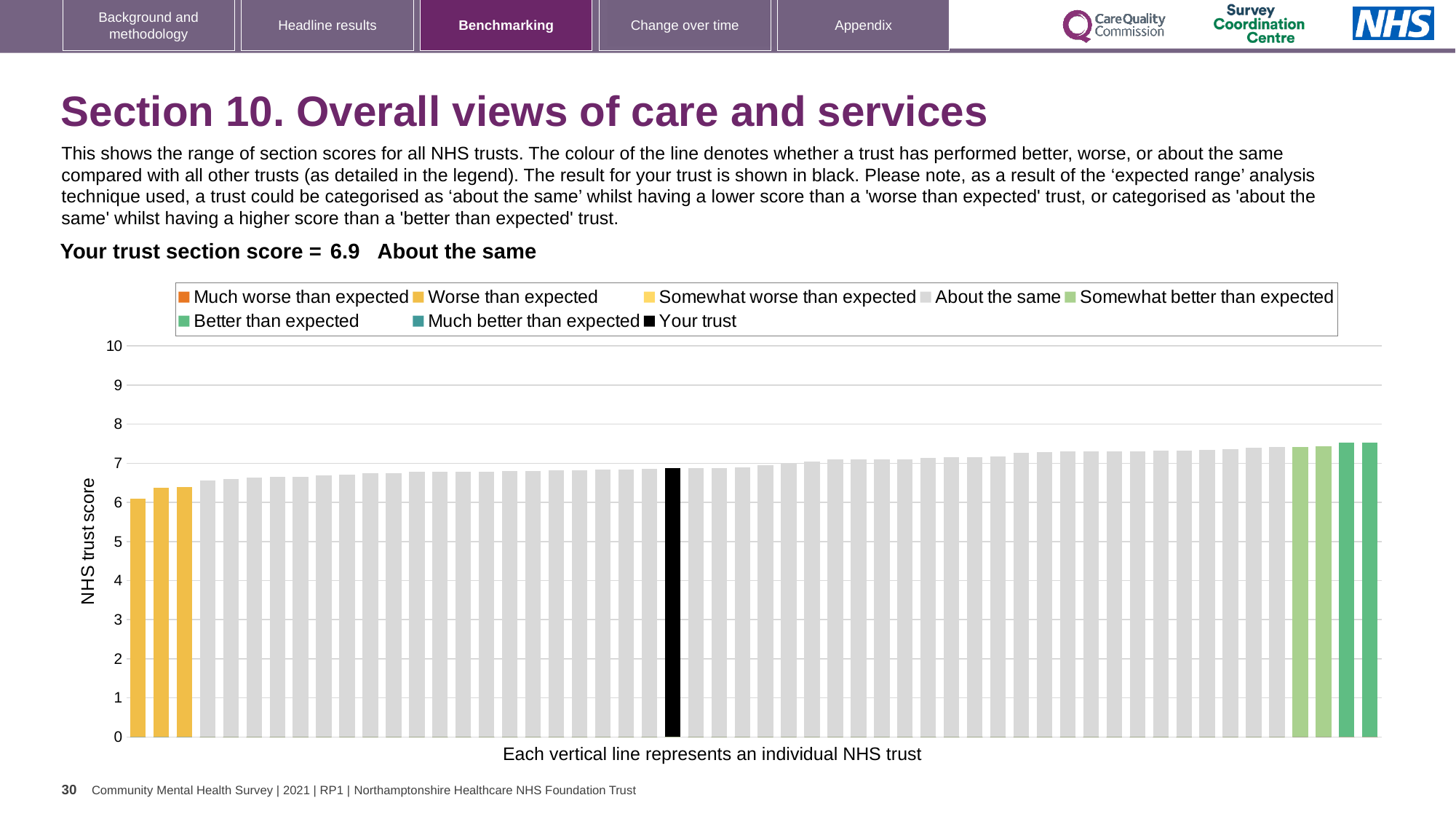
Is the value of the black bar (your trust) greater or less than 5? greater How many bars are coloured as 'Better than expected'? 2 What kind of chart is shown on the slide? bar chart What is the label on the vertical axis of the chart? NHS trust score Is the value of the tallest bar greater or less than 7? greater Which category is your trust placed in for this section? About the same Is the value of the shortest bar greater or less than 7? less Do the bar values rise or fall from left to right across the chart? rise What is the section score for your trust shown on the slide? 6.9 How many entries does the chart legend list? 8 How many bars are coloured as 'Worse than expected'? 3